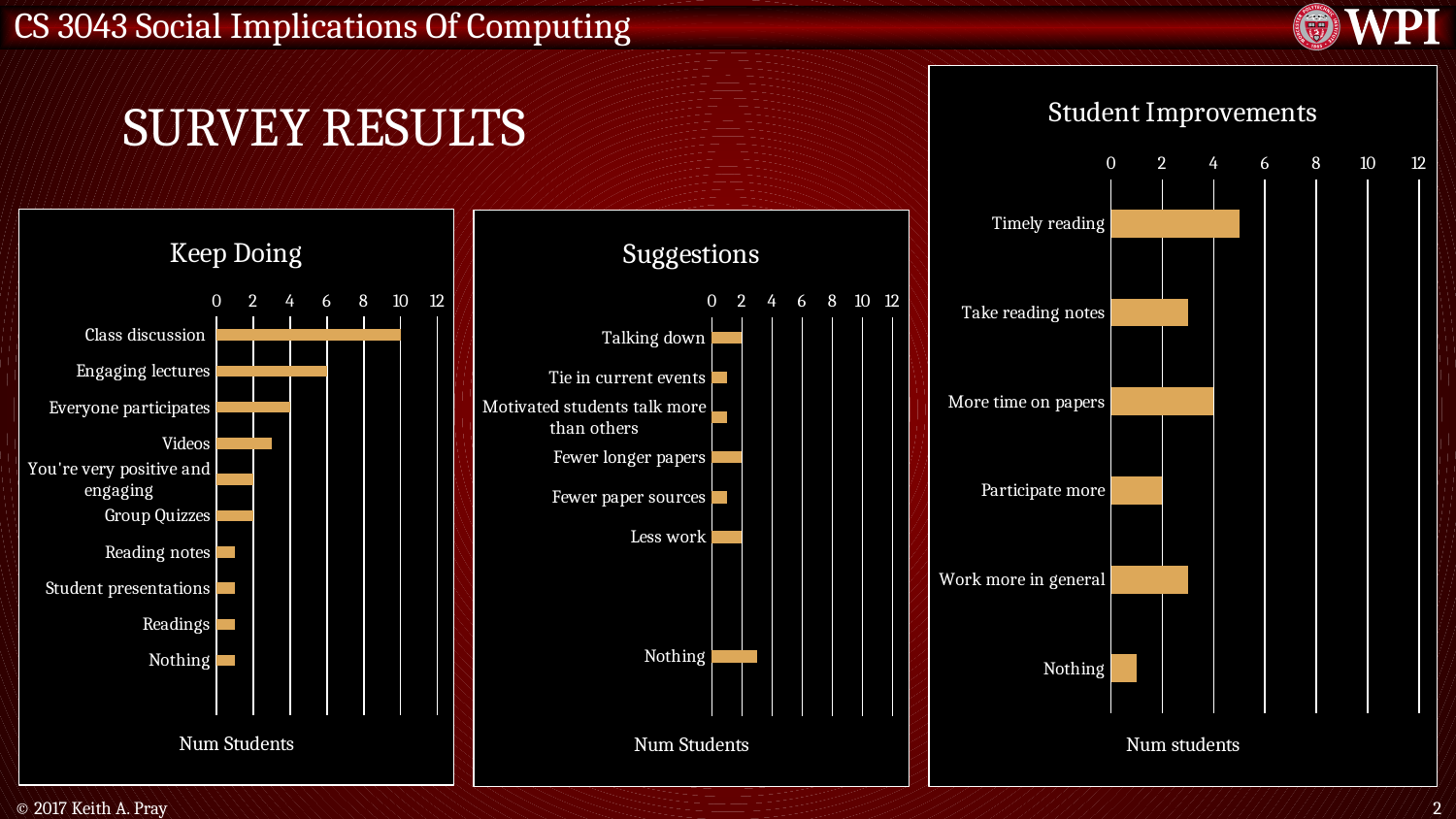
In the Keep Doing chart, what is the value for Engaging lectures? 6 In the Keep Doing chart, which category has the highest number of students? Class discussion In the Keep Doing chart, how many categories are plotted? 10 What kind of chart is the Student Improvements chart? bar chart In the Student Improvements chart, which category has the lowest number of students? Nothing In the Suggestions chart, how many categories are plotted? 7 In the Keep Doing chart, what is the value for Class discussion? 10 In the Suggestions chart, which category has the highest number of students? Nothing In the Keep Doing chart, which is larger, Class discussion or Engaging lectures? Class discussion In the Student Improvements chart, which category has the highest number of students? Timely reading In the Keep Doing chart, is the value for Videos greater or less than 4? less In the Student Improvements chart, what is the value for More time on papers? 4